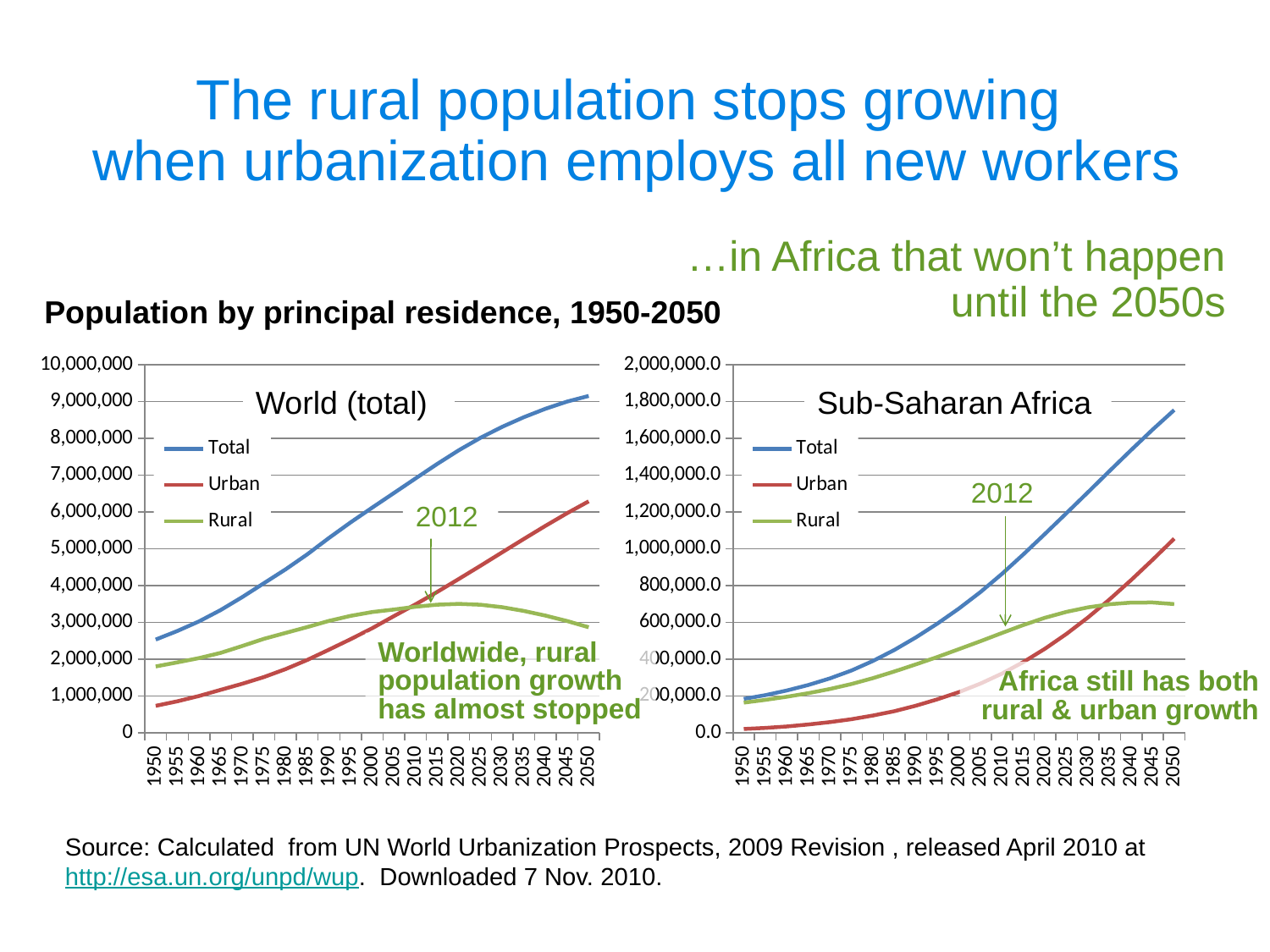
In the Sub-Saharan Africa chart, is the Rural value in 2050 greater or less than 800,000.0? less What kind of chart is the World (total) chart? line chart What colour is the Rural line in the World (total) chart? green In the World (total) chart, how many years are labelled along the x axis? 21 How many series does the legend of the Sub-Saharan Africa chart list? 3 In the World (total) chart, does the Total line rise or fall from 1950 to 2050? rises In the Sub-Saharan Africa chart, which is larger in 1950, Urban or Rural? Rural In the World (total) chart, is the Urban value in 1950 greater or less than 1,000,000? less In the Sub-Saharan Africa chart, is the Total value in 2050 greater or less than 1,600,000.0? greater In the Sub-Saharan Africa chart, which series has the lowest value in 1950? Urban In the World (total) chart, which is larger in 2050, Urban or Rural? Urban